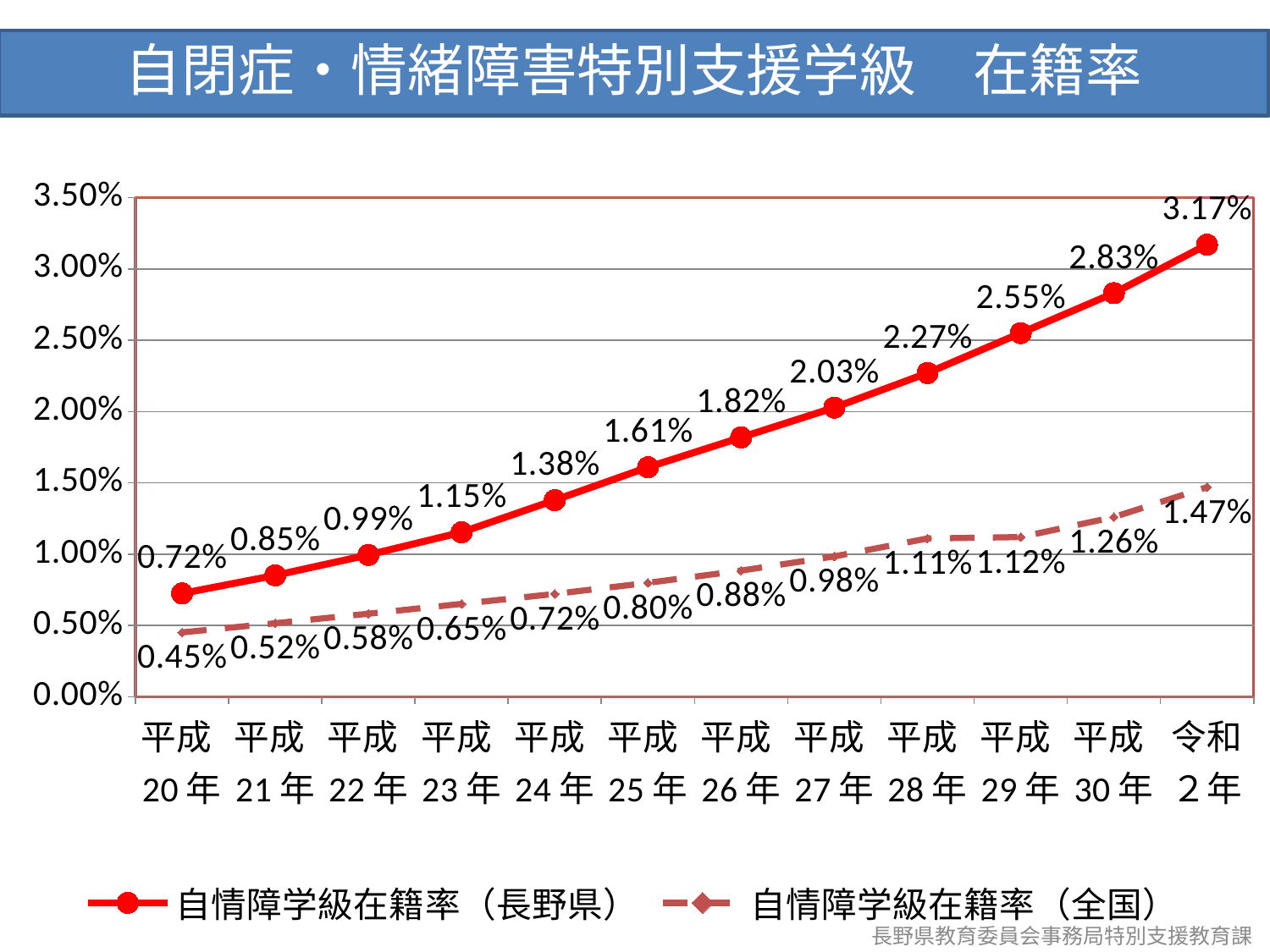
Which is larger in 平成24年: 自情障学級在籍率（長野県） or 自情障学級在籍率（全国）? 自情障学級在籍率（長野県） What is the value of 自情障学級在籍率（長野県） for 令和2年? 3.17% What is the value of 自情障学級在籍率（全国） for 平成20年? 0.45% What is the value of 自情障学級在籍率（全国） for 平成28年? 1.11% What kind of chart is shown on the slide? Line chart In which year is 自情障学級在籍率（長野県） highest? 令和2年 In which year is 自情障学級在籍率（全国） lowest? 平成20年 Does 自情障学級在籍率（長野県） rise or fall from 平成20年 to 令和2年? Rise What is the difference between 自情障学級在籍率（長野県） and 自情障学級在籍率（全国） in 令和2年? 1.70% How many years are shown on the x axis? 12 What is the value of 自情障学級在籍率（長野県） for 平成25年? 1.61% How many series does the legend list? 2